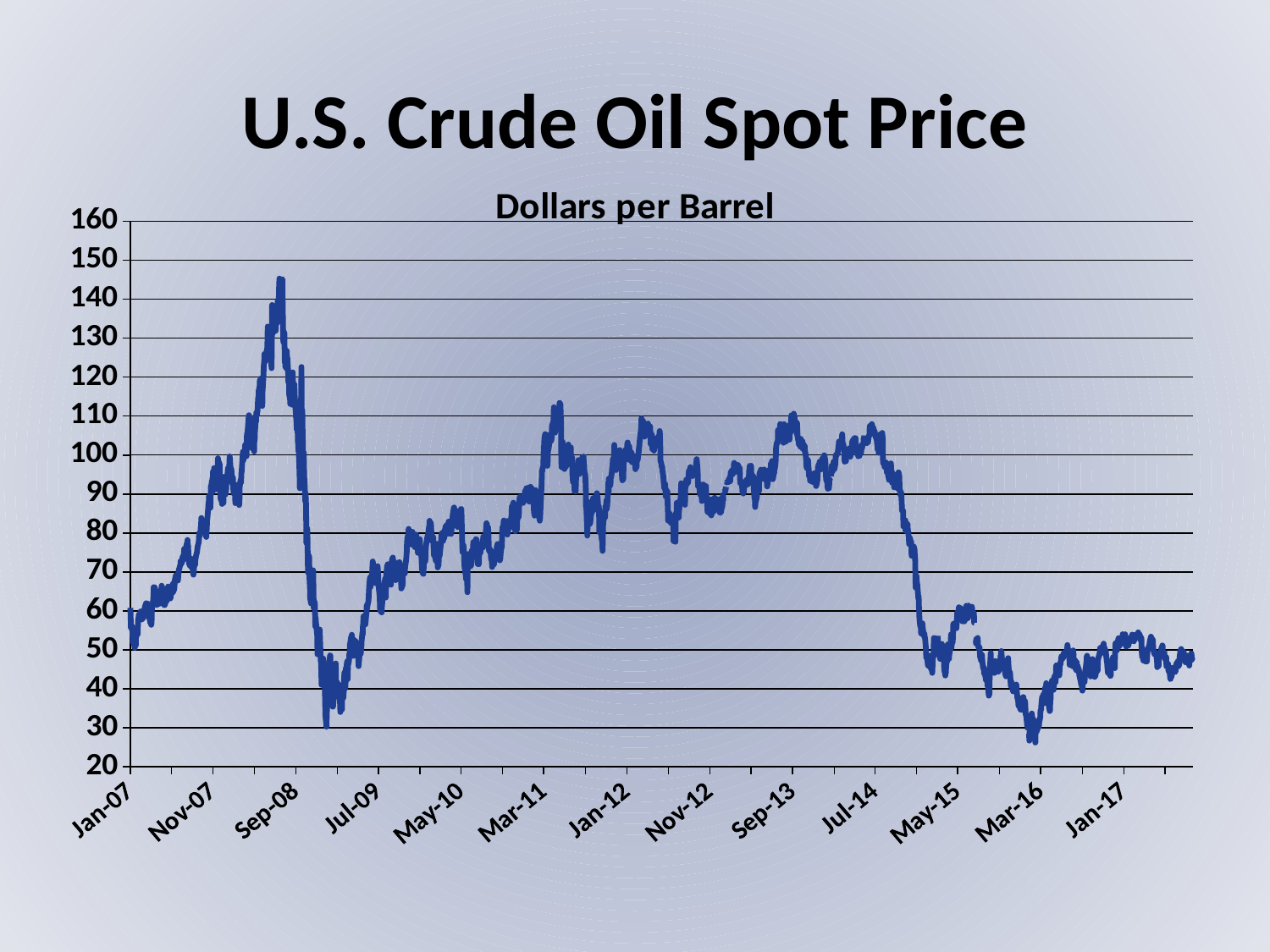
Is the value at Mar-16 greater or less than 50? less What unit is the crude oil price plotted in, according to the chart subtitle? Dollars per Barrel How many date labels are shown along the x axis? 13 How many data series are plotted on the chart? 1 Does the crude oil price rise or fall between Jul-14 and May-15? fall What kind of chart is shown on the slide? line chart Which is larger, the value at Sep-13 or the value at Mar-16? Sep-13 Is the lowest value of the crude oil price greater or less than 30? less Is the peak value of the crude oil price greater or less than 140? greater What is the title of the chart? U.S. Crude Oil Spot Price